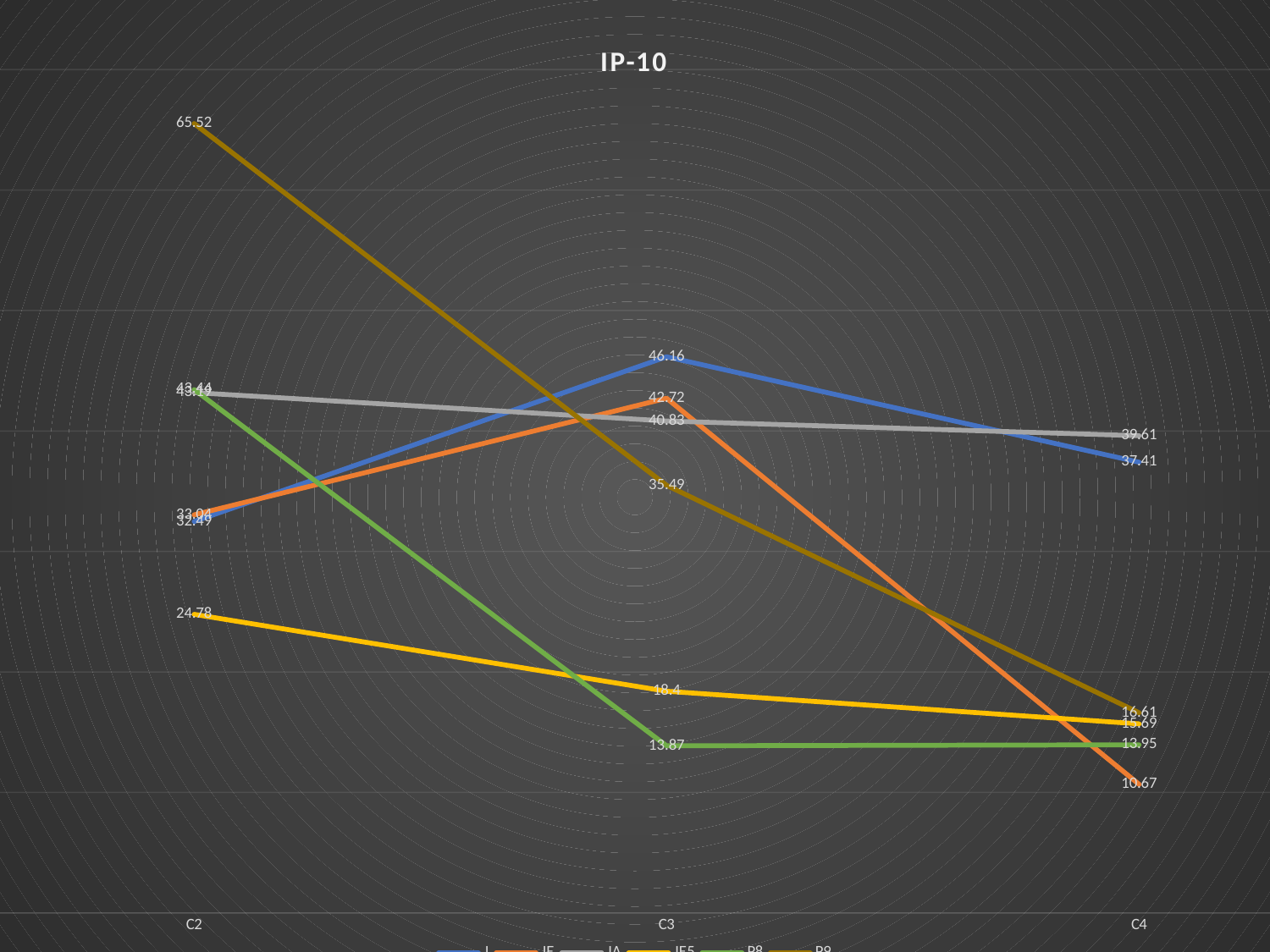
At C4, which is larger: the grey line's value or the blue line's value? the grey line What kind of chart is shown on the slide? line chart How many series are plotted in the chart? 6 What is the difference between the blue line's value at C3 (46.16) and at C4 (37.41)? 8.75 How many categories are shown on the x axis? 3 What is the highest value labelled at C3? 46.16 What is the title of the chart? IP-10 What is the lowest value labelled at C4? 10.67 What is the value of the green line at C4? 13.95 What is the value of the dark gold line at C2? 65.52 What is the highest value labelled anywhere in the chart? 65.52 What is the value of the yellow line at C3? 18.4